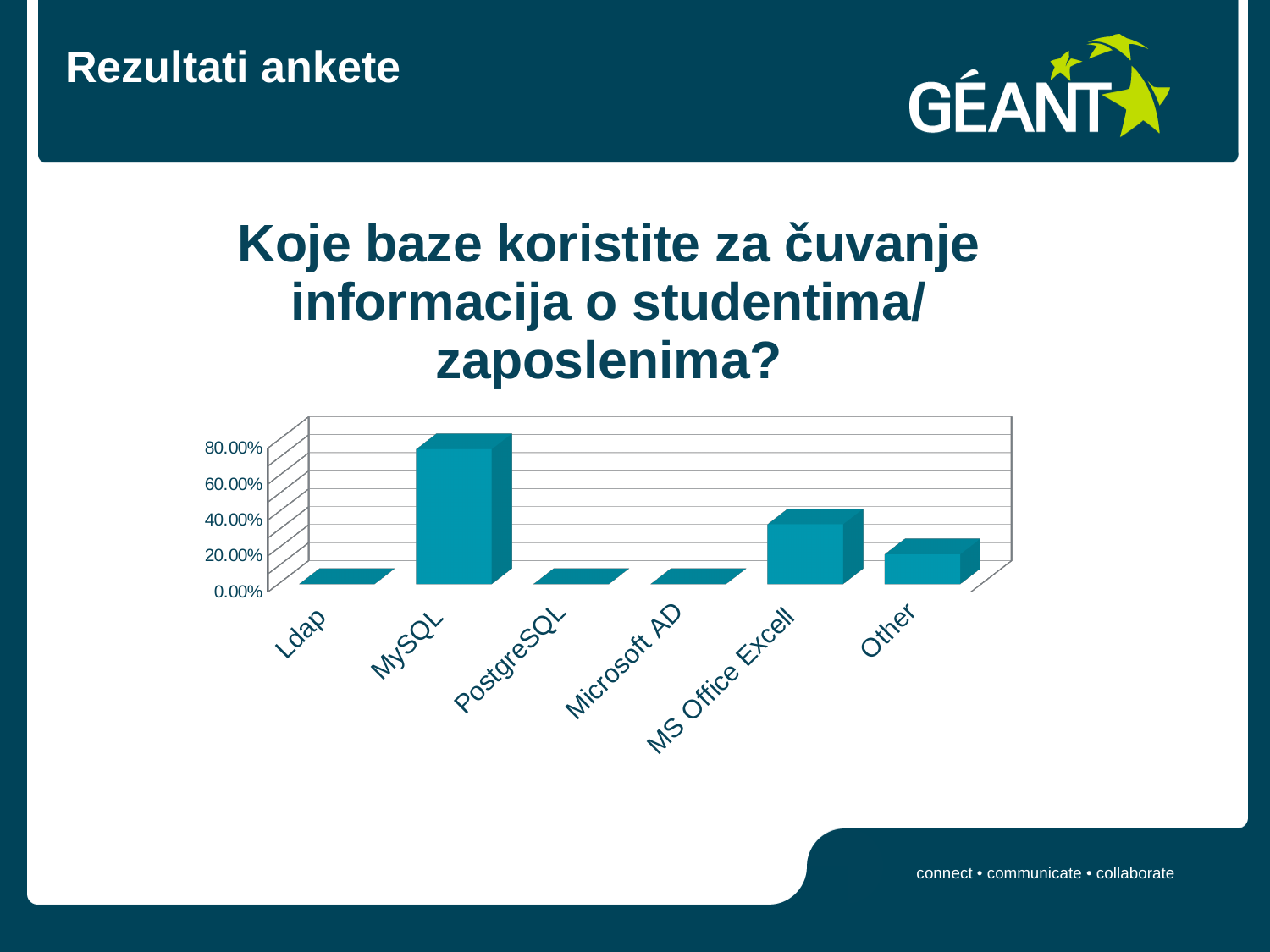
What is the title of the chart? Koje baze koristite za čuvanje informacija o studentima/ zaposlenima? Is the value for MS Office Excell greater or less than 20.00%? greater Which category has the highest value in the chart? MySQL What kind of chart is shown on the slide? bar chart Which has a larger value, Other or PostgreSQL? Other Is the value for Ldap greater or less than 20.00%? less Is the value for Other greater or less than 40.00%? less Which has a larger value, MySQL or MS Office Excell? MySQL How many categories are shown on the x axis of the chart? 6 Which has a larger value, MS Office Excell or Other? MS Office Excell